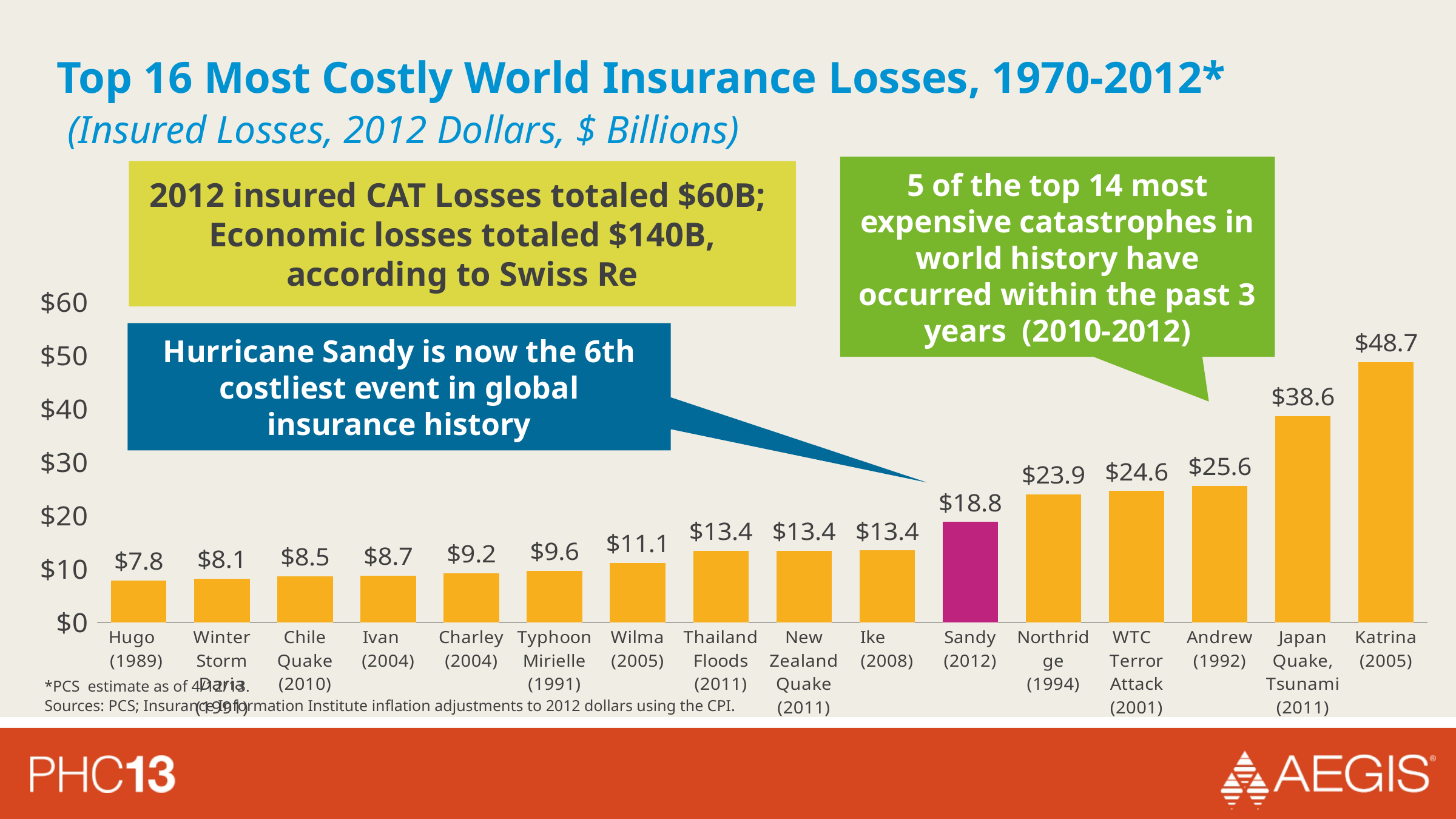
Is the value for Japan Quake, Tsunami (2011) greater or less than $30? greater What is the difference between the values for Katrina (2005) and Japan Quake, Tsunami (2011)? $10.1 What is the insured loss value shown for Katrina (2005)? $48.7 How many events (bars) are shown on the chart? 16 What type of chart is shown on the slide? Bar chart What is the insured loss value shown for the WTC Terror Attack (2001)? $24.6 Which has a larger insured loss, Andrew (1992) or Northridge (1994)? Andrew (1992) Which event has the highest insured loss on the chart? Katrina (2005) Which bar is highlighted in a different colour (magenta) from the others? Sandy (2012) What is the insured loss value shown for Sandy (2012)? $18.8 Which event has the lowest insured loss on the chart? Hugo (1989) What is the difference between the values for Sandy (2012) and Ike (2008)? $5.4